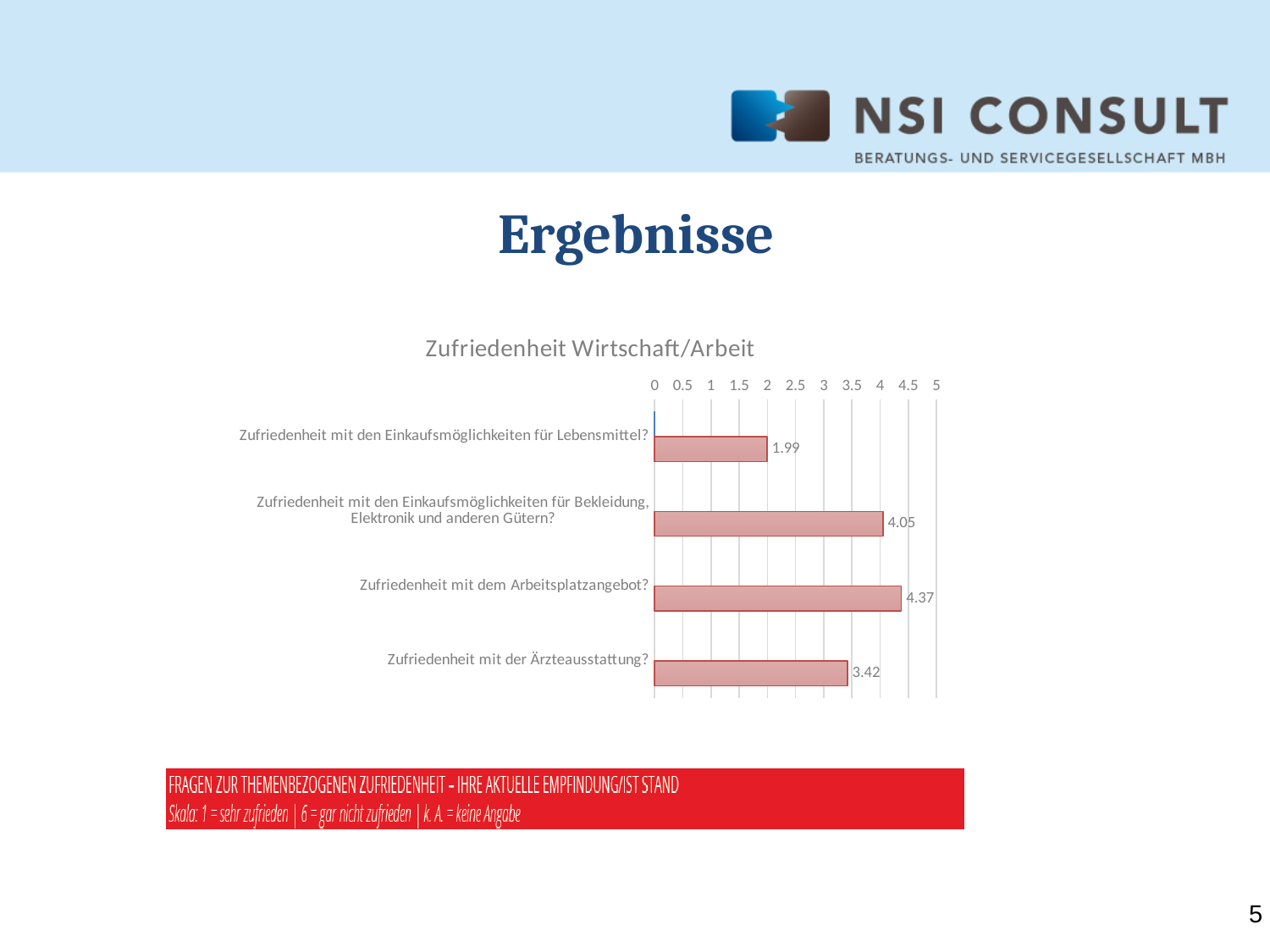
What is the value for "Zufriedenheit mit den Einkaufsmöglichkeiten für Lebensmittel?"? 1.99 What is the value for "Zufriedenheit mit den Einkaufsmöglichkeiten für Bekleidung, Elektronik und anderen Gütern?"? 4.05 Is the value for "Zufriedenheit mit den Einkaufsmöglichkeiten für Lebensmittel?" greater or less than 2.5? less How many categories are shown in the chart? 4 What is the value for "Zufriedenheit mit der Ärzteausstattung?"? 3.42 Which category has the lowest value? Zufriedenheit mit den Einkaufsmöglichkeiten für Lebensmittel? What kind of chart is shown on the slide? bar chart What is the difference between the value for "Zufriedenheit mit dem Arbeitsplatzangebot?" and the value for "Zufriedenheit mit der Ärzteausstattung?"? 0.95 Which category has the highest value? Zufriedenheit mit dem Arbeitsplatzangebot? What is the title of the chart? Zufriedenheit Wirtschaft/Arbeit What is the value for "Zufriedenheit mit dem Arbeitsplatzangebot?"? 4.37 Which is larger: the value for "Zufriedenheit mit den Einkaufsmöglichkeiten für Bekleidung, Elektronik und anderen Gütern?" or the value for "Zufriedenheit mit der Ärzteausstattung?"? Zufriedenheit mit den Einkaufsmöglichkeiten für Bekleidung, Elektronik und anderen Gütern?